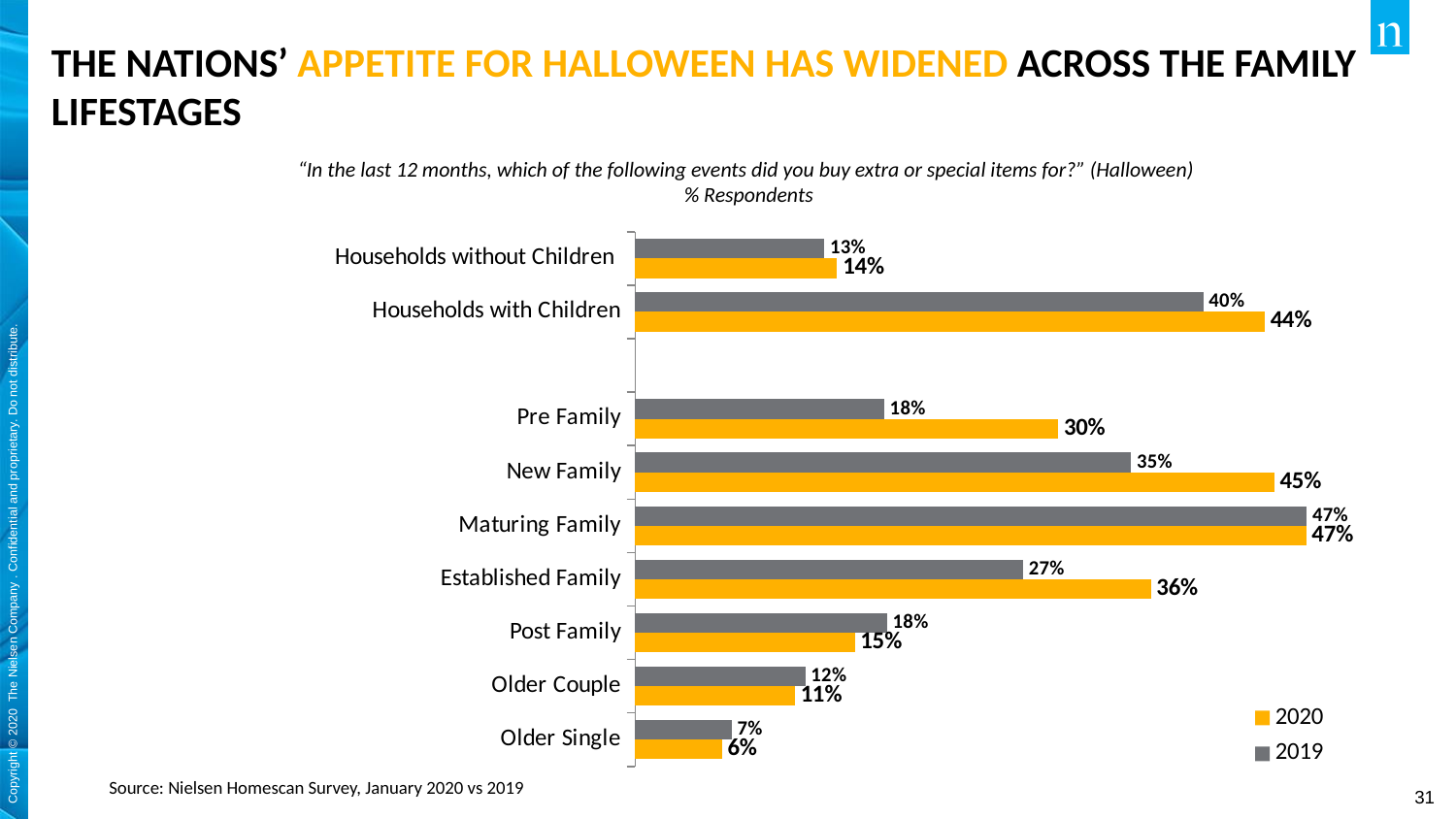
Which category has the lowest 2019 value? Older Single Which colour represents the 2020 series in the legend? Orange What is the difference between the 2020 and 2019 values for Pre Family? 12% What kind of chart is shown on the slide? Bar chart Which category has the highest 2020 value? Maturing Family Which is larger for Post Family, the 2020 value or the 2019 value? 2019 How many categories are shown on the chart? 9 How many series does the legend list? 2 What is the 2020 value for Households with Children? 44% What is the 2020 value for Established Family? 36% What is the 2019 value for Pre Family? 18% What is the difference between the 2020 and 2019 values for New Family? 10%